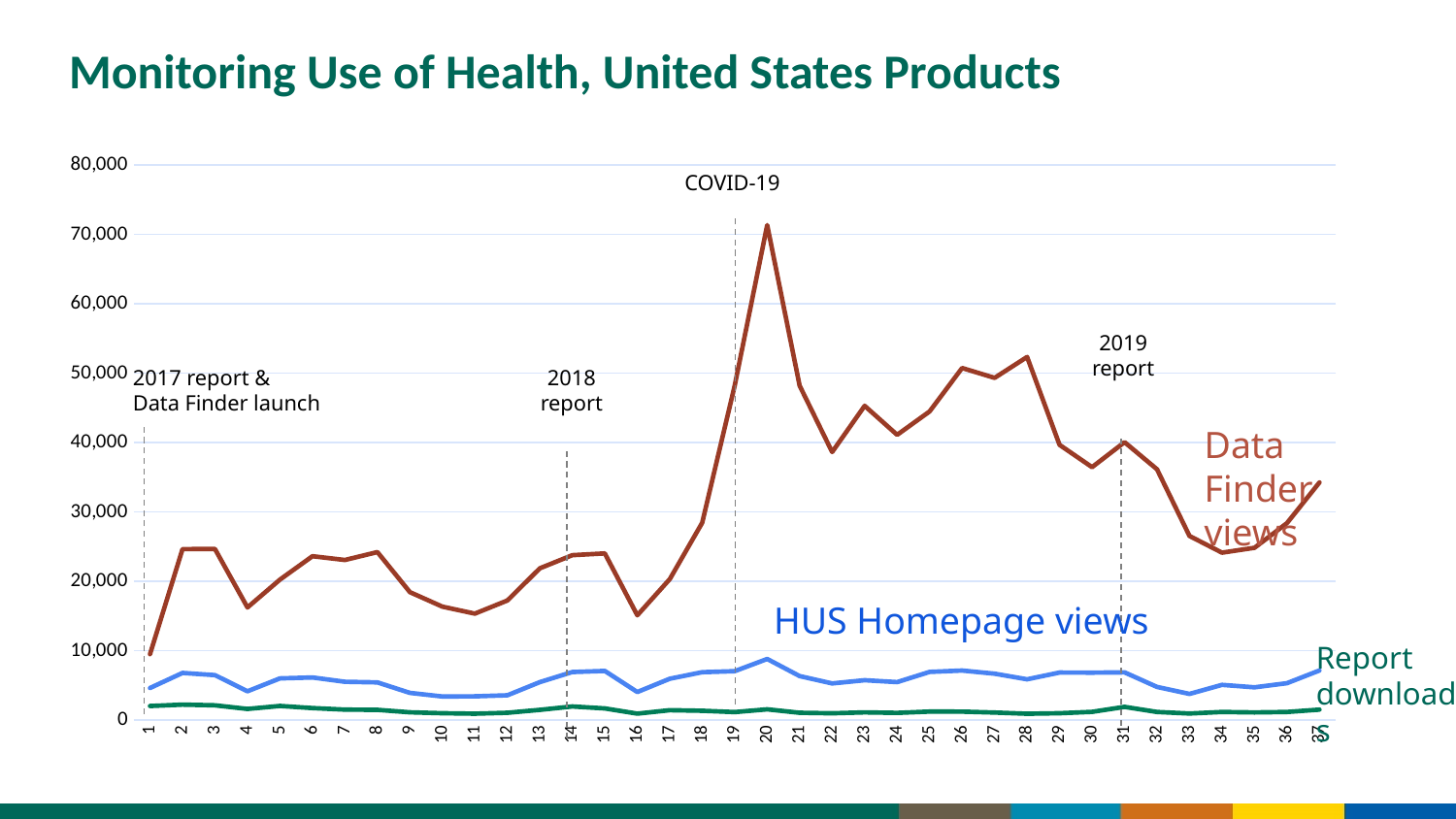
At point 20, which series has the larger value: Data Finder views or HUS Homepage views? Data Finder views Is the value for Data Finder views at point 20 greater or less than 60,000? greater What kind of chart is shown on the slide? Line chart Is the value for HUS Homepage views at point 20 greater or less than 10,000? less Which series has the lowest values across the whole chart? Report downloads Is the value for Data Finder views at point 16 greater or less than 20,000? less How many points are there along the x axis of the chart? 37 How many data series are plotted on the chart? 3 Do Data Finder views rise or fall between point 31 and point 34? Fall At which x-axis point are Data Finder views at their lowest? 1 What event is annotated with a dashed line at point 19 on the chart? COVID-19 At which x-axis point do Data Finder views reach their highest value? 20